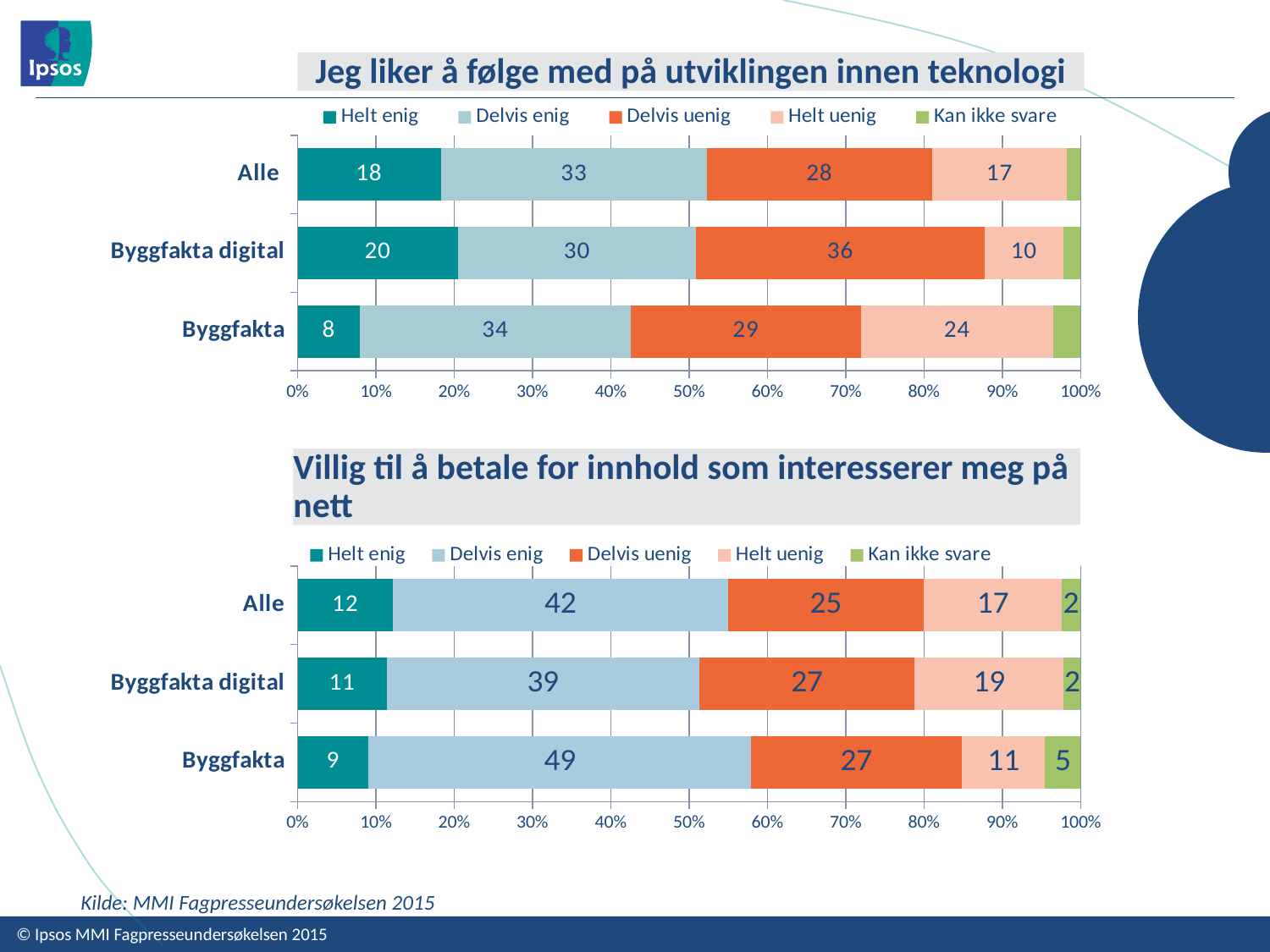
How many series does the legend of the top chart list? 5 In the bottom chart ("Villig til å betale for innhold som interesserer meg på nett"), what is the difference between the "Helt uenig" values for Alle and Byggfakta? 6 In the bottom chart ("Villig til å betale for innhold som interesserer meg på nett"), is the "Delvis enig" value for Alle larger or smaller than for Byggfakta digital? larger In the top chart ("Jeg liker å følge med på utviklingen innen teknologi"), what is the difference between the "Delvis uenig" values for Byggfakta digital and Alle? 8 In the bottom chart ("Villig til å betale for innhold som interesserer meg på nett"), what is the value of "Kan ikke svare" for Byggfakta? 5 In the top chart ("Jeg liker å følge med på utviklingen innen teknologi"), which category has the highest "Delvis uenig" value? Byggfakta digital What kind of chart is the bottom chart ("Villig til å betale for innhold som interesserer meg på nett")? Stacked bar chart In the bottom chart ("Villig til å betale for innhold som interesserer meg på nett"), which category has the highest "Helt uenig" value? Byggfakta digital In the bottom chart ("Villig til å betale for innhold som interesserer meg på nett"), what is the value of "Delvis enig" for Byggfakta? 49 In the top chart ("Jeg liker å følge med på utviklingen innen teknologi"), what is the value of "Helt enig" for Byggfakta digital? 20 In the top chart ("Jeg liker å følge med på utviklingen innen teknologi"), which category has the lowest "Helt enig" value? Byggfakta In the top chart ("Jeg liker å følge med på utviklingen innen teknologi"), what is the value of "Helt uenig" for Byggfakta? 24